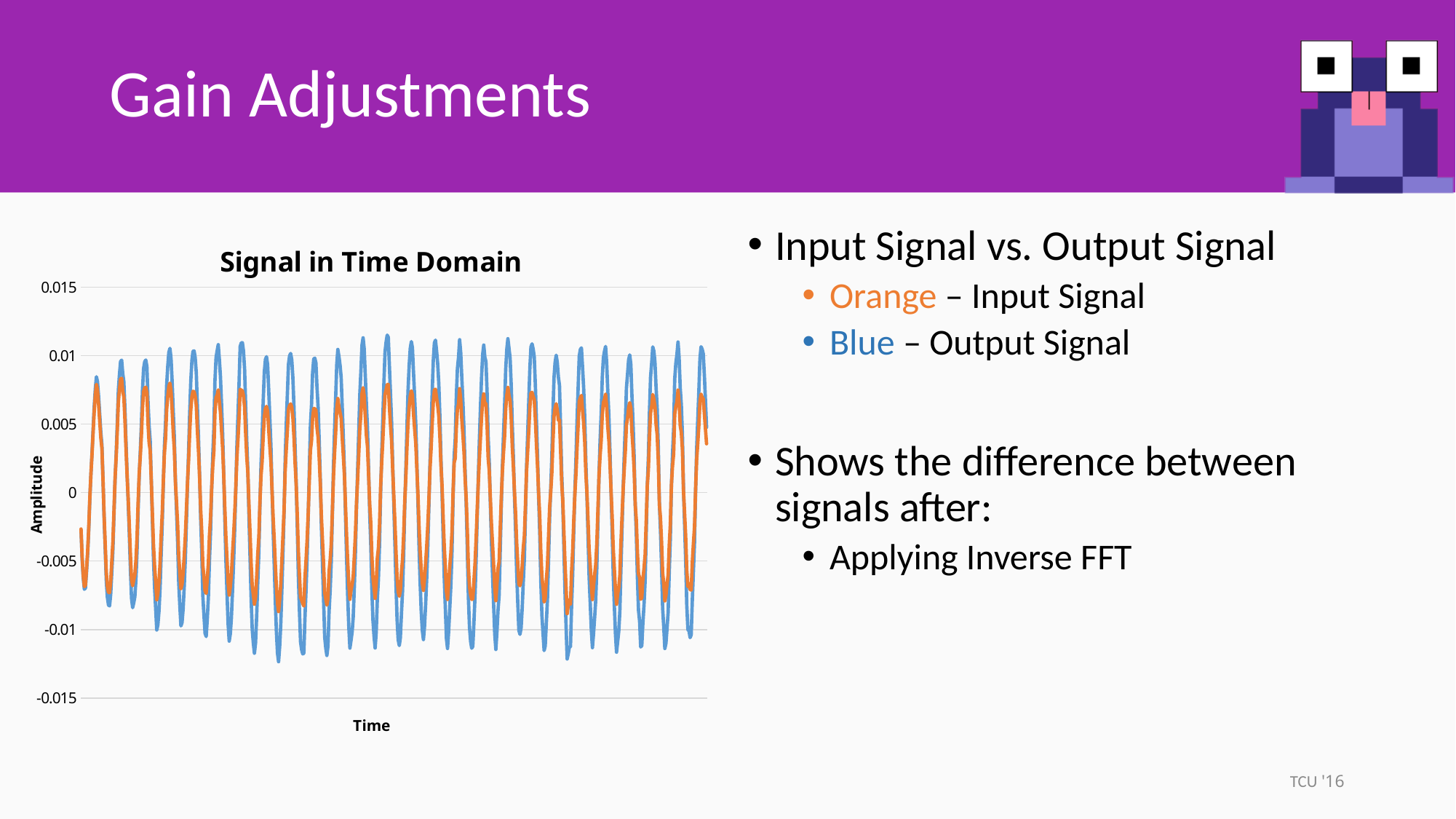
Which line reaches higher peaks, the orange line or the blue line? blue What is the maximum value shown on the vertical axis of the chart? 0.015 What is the title of the chart? Signal in Time Domain Are the peaks of the orange line greater or less than 0.01? less How many lines (series) are plotted on the chart? 2 Are the lowest troughs of the blue line greater or less than -0.01? less What kind of chart is shown on the slide? line chart What is the label on the vertical axis of the chart? Amplitude Which signal does the orange line represent according to the slide? Input Signal Are the troughs of the orange line greater or less than -0.01? greater Which signal does the blue line represent according to the slide? Output Signal